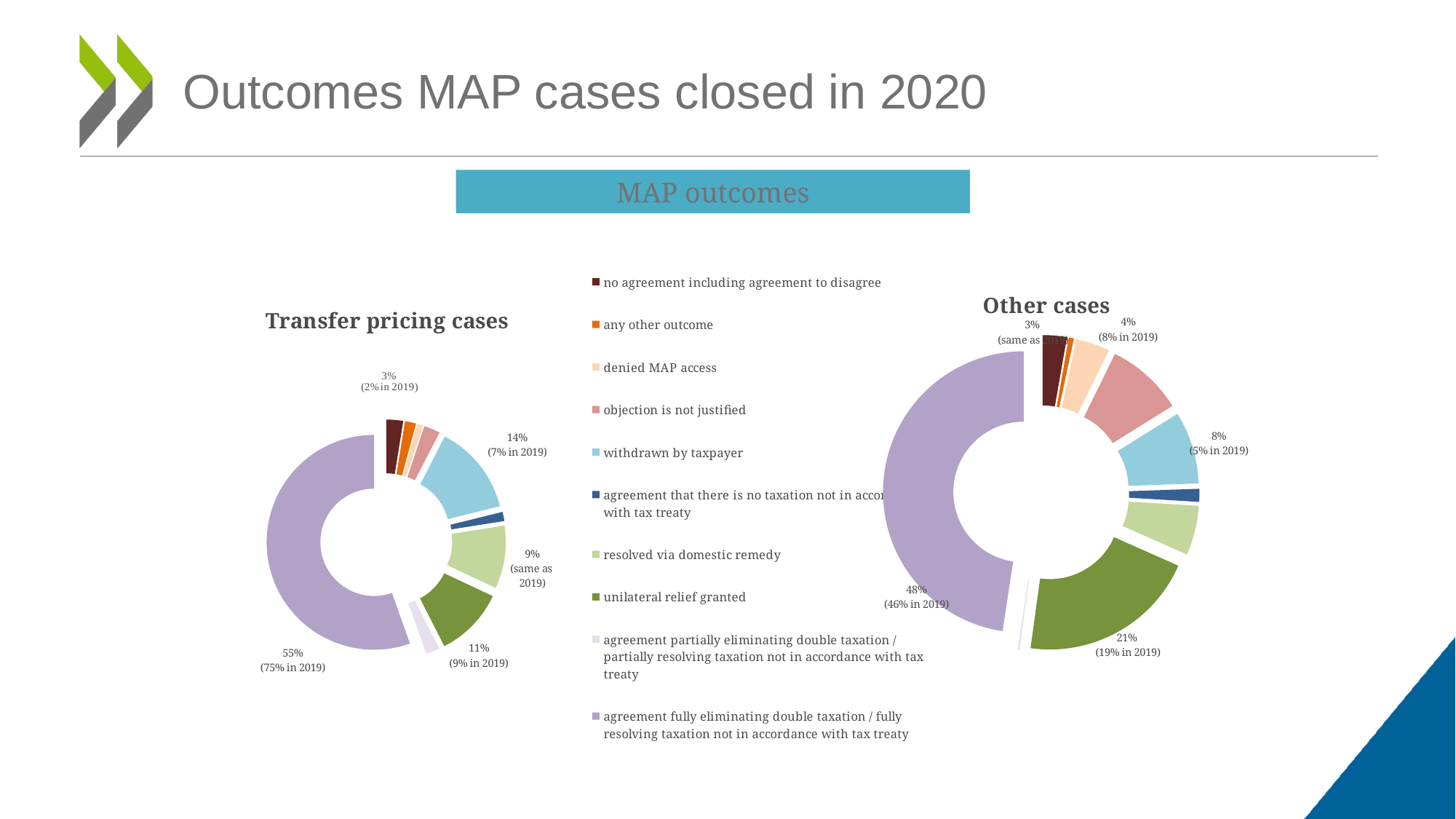
What is the title of the chart on the right side of the slide? Other cases Which chart shows a larger share for unilateral relief granted, Transfer pricing cases or Other cases? Other cases In the Other cases chart, what share of cases was resolved by agreement fully eliminating double taxation / fully resolving taxation not in accordance with tax treaty? 48% In the Other cases chart, what share of cases had unilateral relief granted? 21% In the Transfer pricing cases chart, what share of cases was withdrawn by taxpayer? 14% In the Transfer pricing cases chart, what is the difference in percentage points between the share for agreement fully eliminating double taxation and the share for withdrawn by taxpayer? 41 In the Transfer pricing cases chart, which outcome has the largest share? agreement fully eliminating double taxation / fully resolving taxation not in accordance with tax treaty What type of chart is used for Transfer pricing cases and Other cases? Pie (donut) chart In the Transfer pricing cases chart, what share of cases had unilateral relief granted? 11% In the Other cases chart, what was the share of cases withdrawn by taxpayer in 2019, as shown in the label? 5% In the Transfer pricing cases chart, what was the share of agreement fully eliminating double taxation in 2019, as shown in the label? 75% How many outcome categories does the legend list? 10